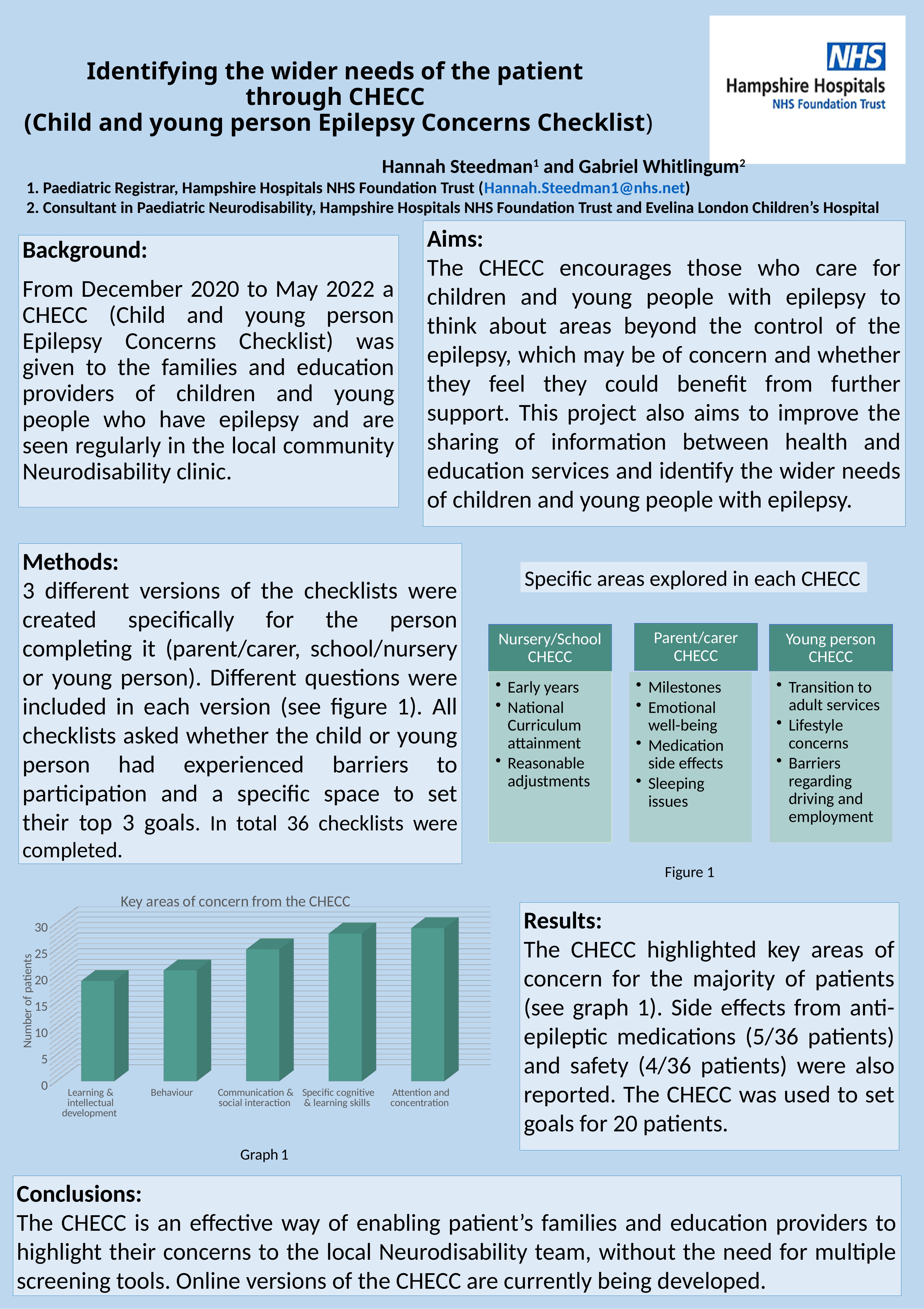
Is the value for Attention and concentration in the "Key areas of concern from the CHECC" chart greater or less than 25? greater What type of chart is shown under the title "Key areas of concern from the CHECC"? bar chart What is the label of the vertical axis in the "Key areas of concern from the CHECC" chart? Number of patients Is the value for Communication & social interaction in the "Key areas of concern from the CHECC" chart greater or less than 30? less In the "Key areas of concern from the CHECC" chart, which has more patients: Behaviour or Specific cognitive & learning skills? Specific cognitive & learning skills Do the values in the "Key areas of concern from the CHECC" chart rise or fall from left to right? rise In the "Key areas of concern from the CHECC" chart, which has more patients: Learning & intellectual development or Attention and concentration? Attention and concentration Is the value for Behaviour in the "Key areas of concern from the CHECC" chart greater or less than 25? less How many categories are plotted in the "Key areas of concern from the CHECC" chart? 5 What is the title of the chart labelled Graph 1? Key areas of concern from the CHECC Which category has the highest number of patients in the "Key areas of concern from the CHECC" chart? Attention and concentration Which category has the lowest number of patients in the "Key areas of concern from the CHECC" chart? Learning & intellectual development